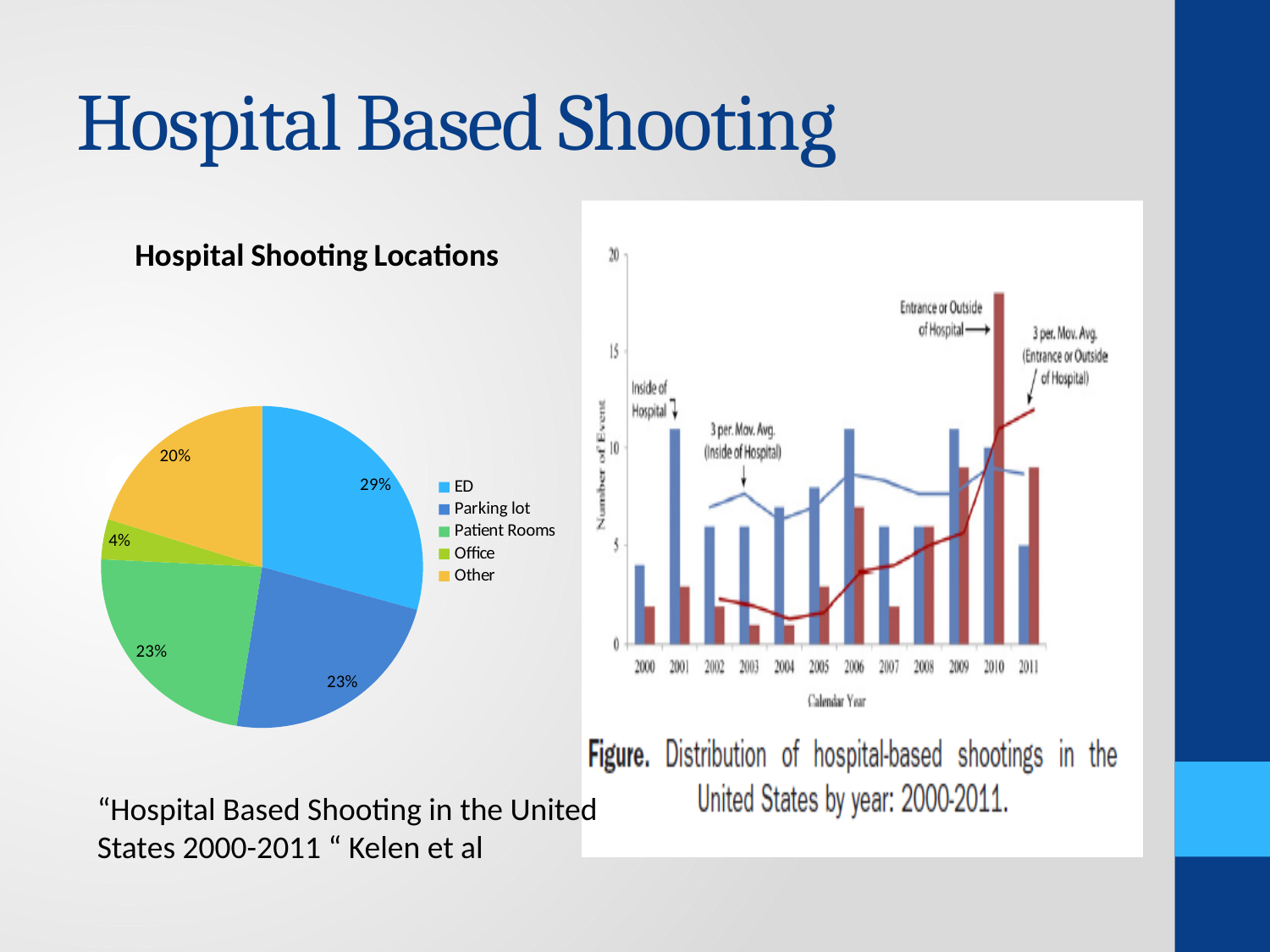
In the Hospital Shooting Locations pie chart, how many location categories does the legend list? 5 In the Distribution of hospital-based shootings chart on the right, how many calendar years are shown on the x axis? 12 In the Hospital Shooting Locations pie chart, how many percentage points larger is the ED share than the Other share? 9 In the Distribution of hospital-based shootings chart on the right, which year has the tallest Entrance or Outside of Hospital bar? 2010 In the Distribution of hospital-based shootings chart on the right, is the Entrance or Outside of Hospital value for 2010 greater or less than 15? greater In the Hospital Shooting Locations pie chart, what percentage is shown for Other? 20% In the Distribution of hospital-based shootings chart on the right, is the Inside of Hospital value for 2000 greater or less than 5? less In the Hospital Shooting Locations pie chart, which location has the largest share? ED In the Hospital Shooting Locations pie chart, which location has the smallest share? Office What kind of chart is the Hospital Shooting Locations chart? pie chart In the Hospital Shooting Locations pie chart, what share of shootings occurred in the ED? 29% In the Hospital Shooting Locations pie chart, what percentage is shown for Office? 4%